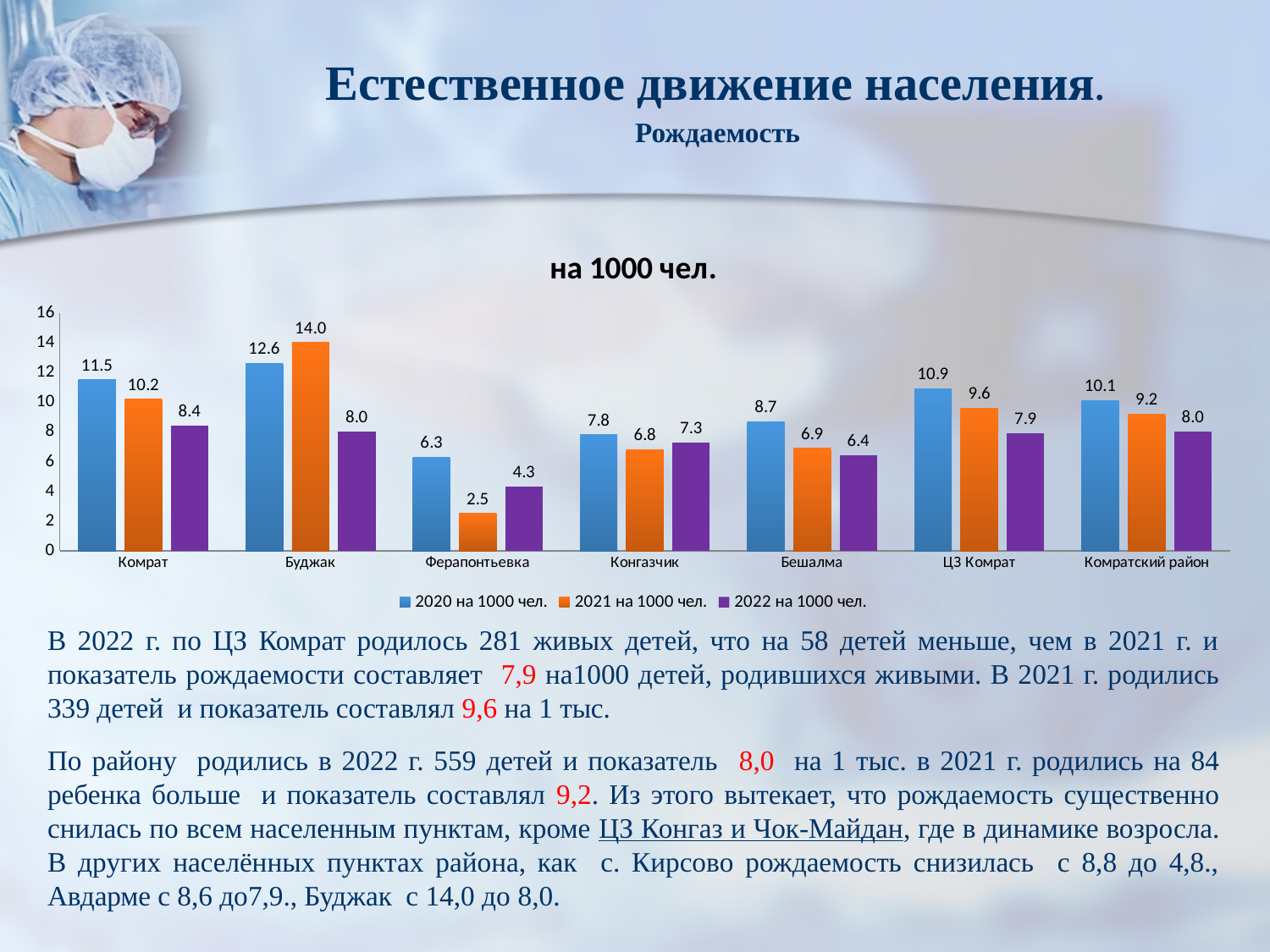
What is the title of the chart? на 1000 чел. What kind of chart is shown? bar chart How many categories are shown on the x axis? 7 What is the 2021 value for Буджак? 14.0 Which category has the lowest 2022 value? Ферапонтьевка Which category has the highest 2021 value? Буджак What is the 2020 value for Ферапонтьевка? 6.3 Do the values for Бешалма rise or fall from 2020 to 2022? fall Which is larger for Конгазчик: the 2021 value or the 2022 value? 2022 How many series does the legend list? 3 What is the difference between the 2020 and 2022 values for Комрат? 3.1 What is the 2022 value for ЦЗ Комрат? 7.9